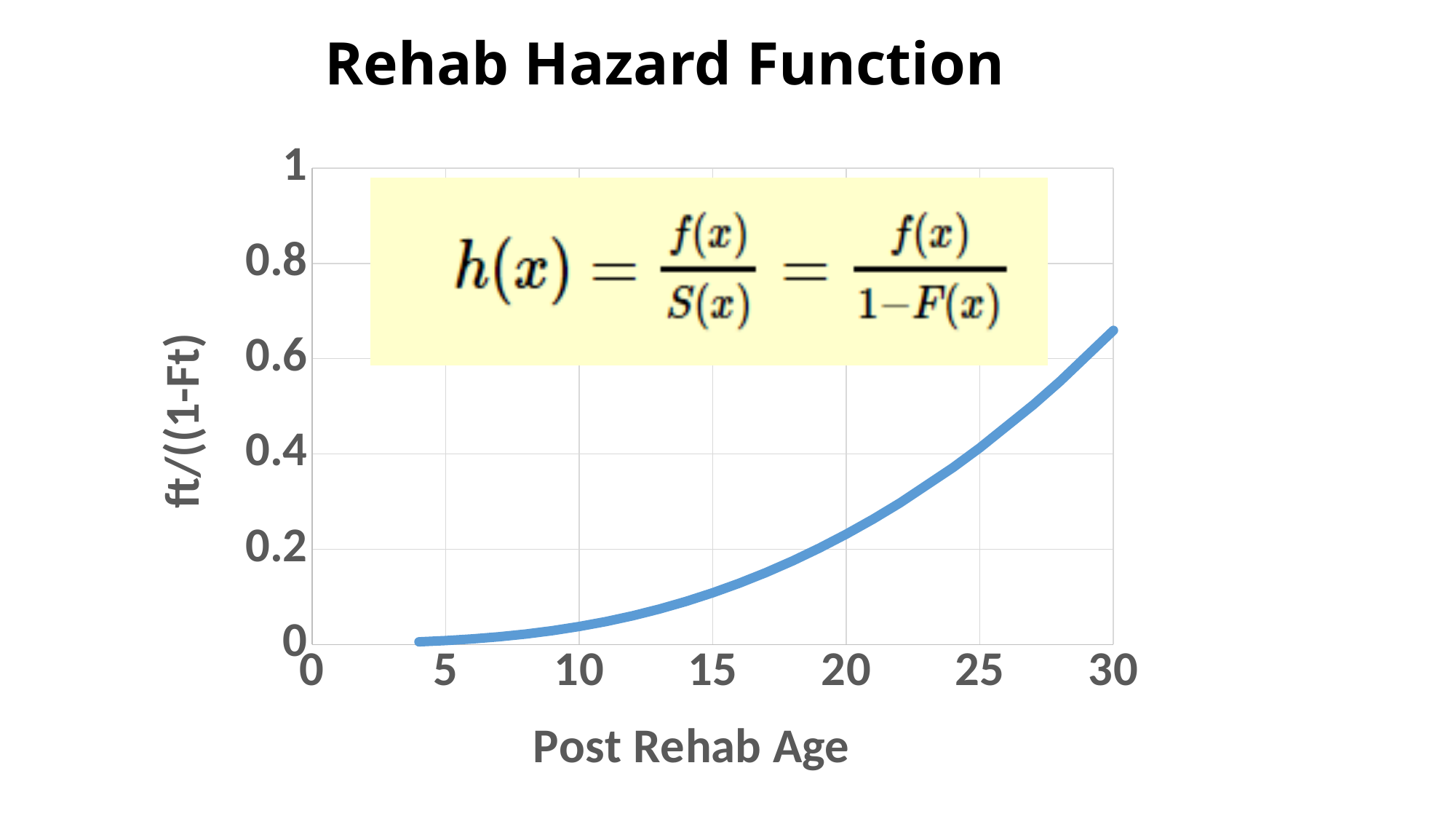
Is the value at Post Rehab Age 20 greater or less than 0.4? less Is the value at Post Rehab Age 25 greater or less than 0.6? less What kind of chart is shown on the slide? line chart What is the highest tick value shown on the y axis? 1 Do the values rise or fall as Post Rehab Age increases? rise At which Post Rehab Age shown does the curve reach its highest value? 30 What is the label of the x axis? Post Rehab Age What is the title of the chart? Rehab Hazard Function Is the value at Post Rehab Age 30 larger or smaller than the value at Post Rehab Age 20? larger Is the value at Post Rehab Age 30 greater or less than 0.6? greater